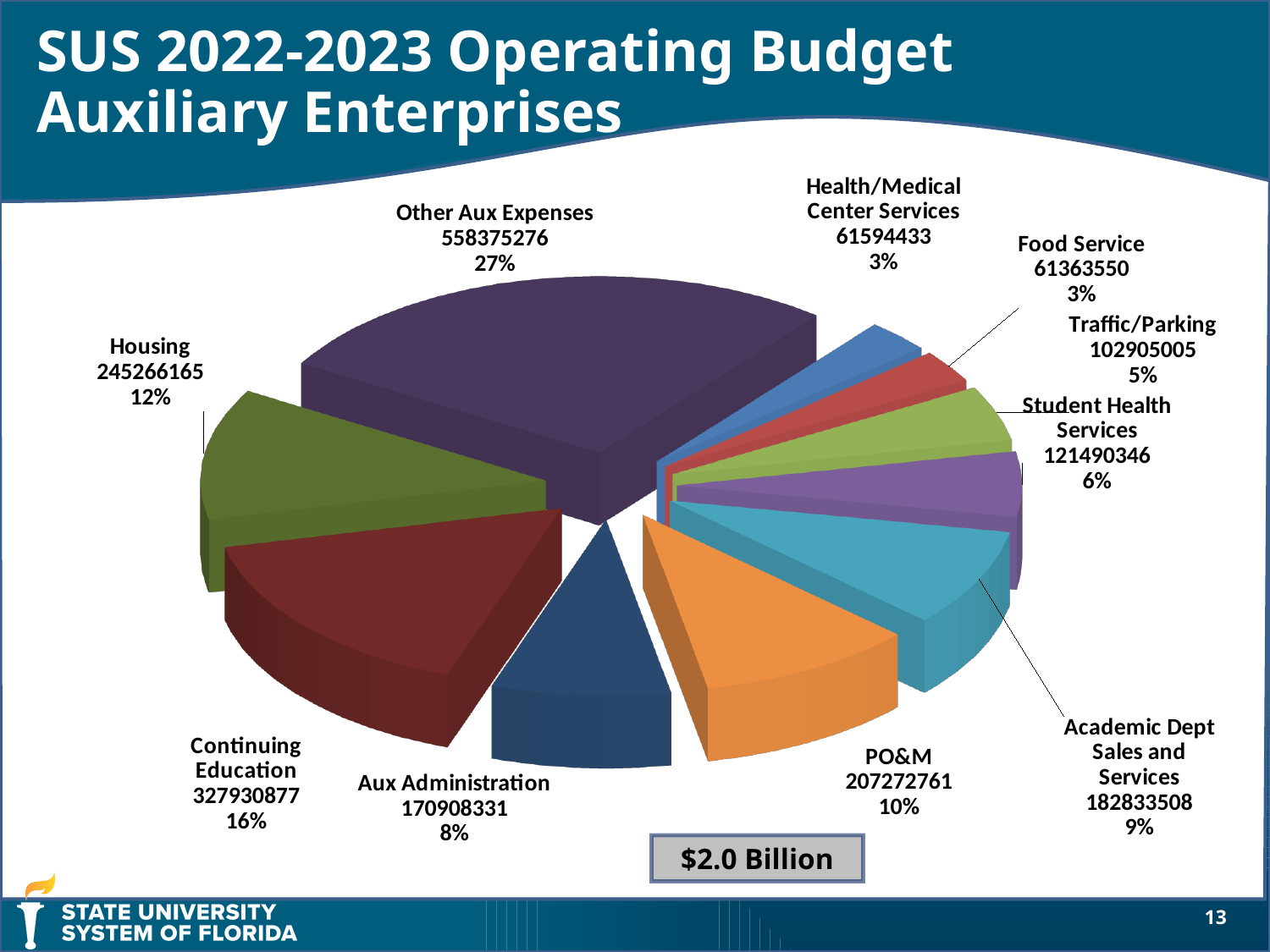
How many categories does the pie chart show? 10 Which is larger, PO&M or Academic Dept Sales and Services? PO&M What is the value shown for PO&M? 207272761 What total amount is shown in the box below the pie chart? $2.0 Billion What is the value shown for Housing? 245266165 What type of chart is shown on the slide? Pie chart Which category has the smallest value in the pie chart? Food Service Which category has the largest slice of the pie chart? Other Aux Expenses What percentage share of the pie does Continuing Education represent? 16% What percentage share of the pie does Student Health Services represent? 6% What is the title of the slide containing the pie chart? SUS 2022-2023 Operating Budget Auxiliary Enterprises What is the difference between the values for Housing and Aux Administration? 74357834